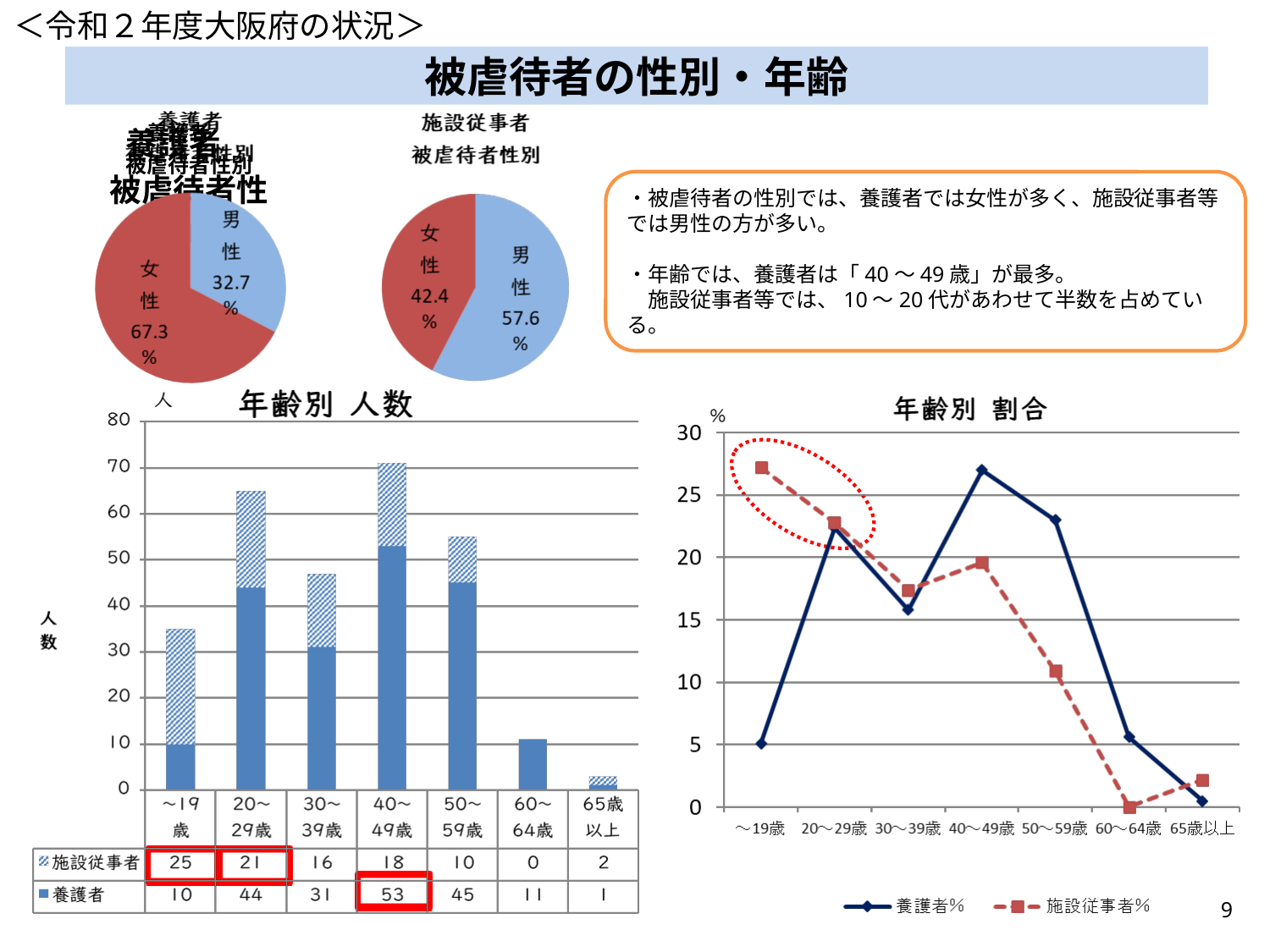
In the 年齢別 人数 chart, what is the total of the stacked bar for 20～29歳? 65 In the 養護者 被虐待者性別 pie chart, what share is 女性? 67.3% In the 年齢別 人数 chart, what is the 養護者 value for 40～49歳? 53 In the 年齢別 人数 chart, how many age categories are shown on the x axis? 7 In the 施設従事者 被虐待者性別 pie chart, which slice is larger, 女性 or 男性? 男性 In the 年齢別 人数 chart, which age category has the highest 養護者 value? 40～49歳 In the 年齢別 人数 chart, which age category has the lowest 施設従事者 value? 60～64歳 In the 年齢別 割合 chart, is the 養護者% value for 40～49歳 greater or less than 25? greater In the 年齢別 人数 chart, what is the 施設従事者 value for ～19歳? 25 In the 施設従事者 被虐待者性別 pie chart, what share is 男性? 57.6% In the 年齢別 人数 chart, what is the difference between the 養護者 and 施設従事者 values for 50～59歳? 35 In the 年齢別 割合 chart, how many series does the legend list? 2